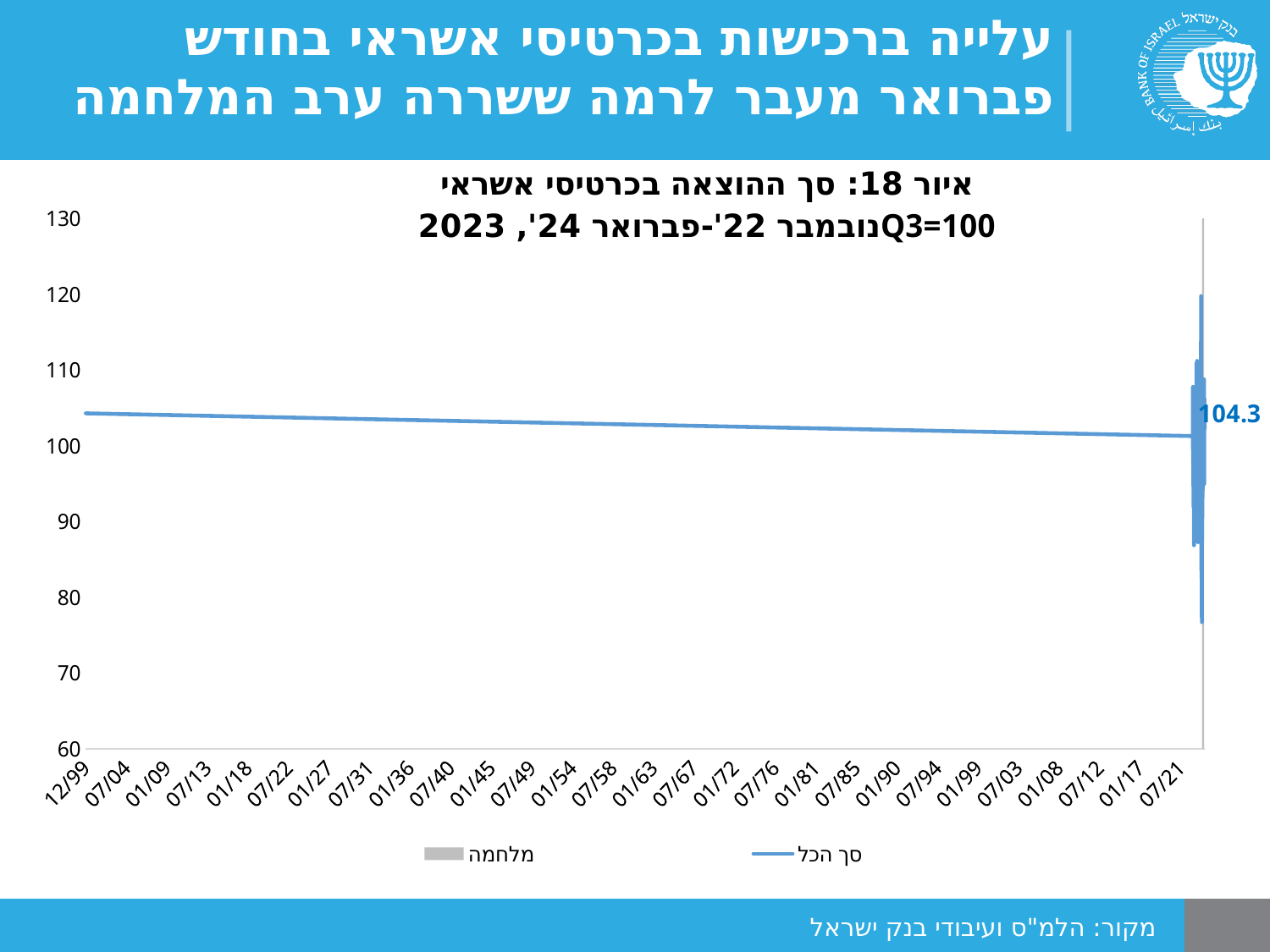
What are the two entries in the chart legend? סך הכל and מלחמה Is the labelled value 104.3 at the end of the line greater or less than 110? less What kind of chart is shown on the slide? line chart What is the data label shown at the right end of the line in the chart? 104.3 Is the labelled value 104.3 at the end of the line greater or less than 100? greater What is the lowest value shown on the vertical axis? 60 Is the value of the line at the left end of the chart greater or less than 110? less How many series does the chart legend list? 2 What is the figure number given in the chart title? איור 18 What is the highest value shown on the vertical axis? 130 What is the first label on the horizontal axis? 12/99